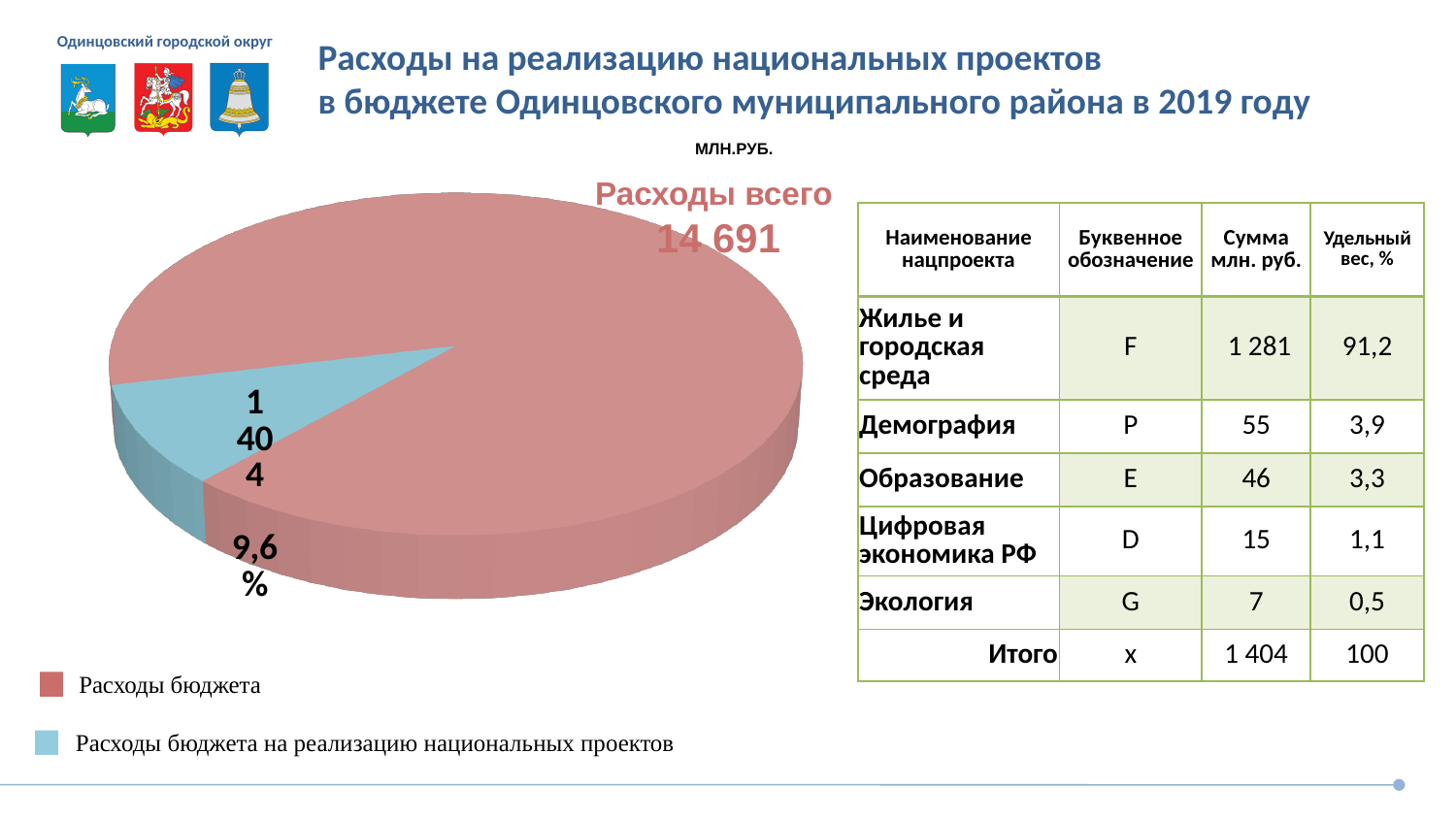
Which slice of the pie chart is the largest? Расходы бюджета How many entries does the legend of the pie chart list? 2 Which slice of the pie chart is the smallest? Расходы бюджета на реализацию национальных проектов What total value ('Расходы всего') is printed on the pie chart? 14 691 How many slices does the pie chart have? 2 What kind of chart is shown on the slide? pie chart Which is larger in the pie chart: 'Расходы бюджета' or 'Расходы бюджета на реализацию национальных проектов'? Расходы бюджета In what units are the values of the pie chart given, according to the label above the chart? млн.руб. What share of the pie does the slice 'Расходы бюджета на реализацию национальных проектов' represent, as printed on the chart? 9,6 % What value is printed on the pie chart for the slice 'Расходы бюджета на реализацию национальных проектов'? 1 404 What colour is the slice for 'Расходы бюджета на реализацию национальных проектов' in the pie chart? light blue